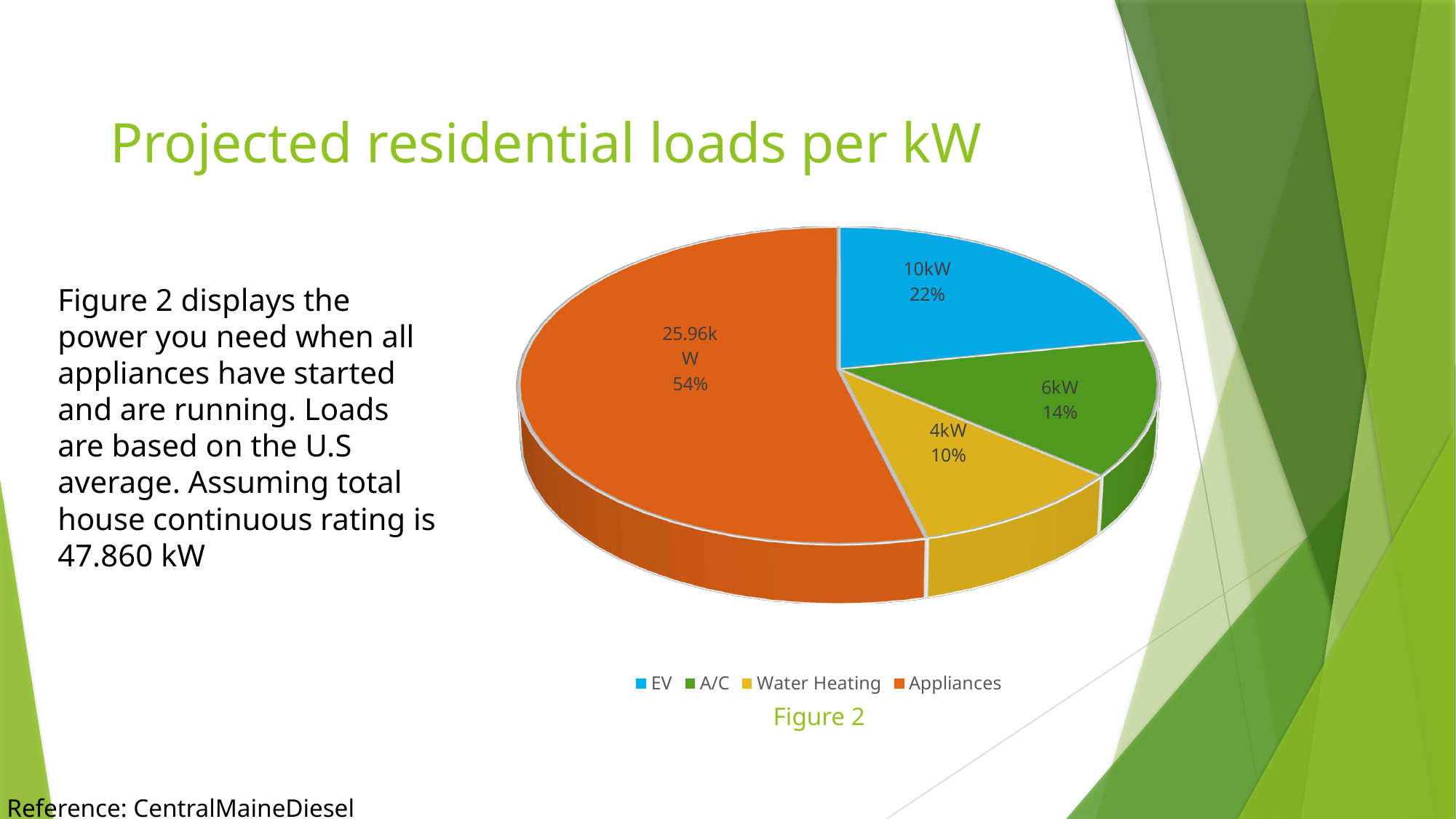
Which has a larger load, A/C or Water Heating? A/C What is the load value for Water Heating in the pie chart? 4kW How many categories does the legend of the pie chart list? 4 What share of the pie does EV represent? 22% What type of chart is shown on the slide? pie chart What share of the pie does Appliances represent? 54% Which category has the largest slice in the pie chart? Appliances What is the difference in load between EV and A/C? 4kW What is the load value for EV in the pie chart? 10kW Which category has the smallest slice in the pie chart? Water Heating What is the load value for A/C in the pie chart? 6kW What is the load value for Appliances in the pie chart? 25.96kW